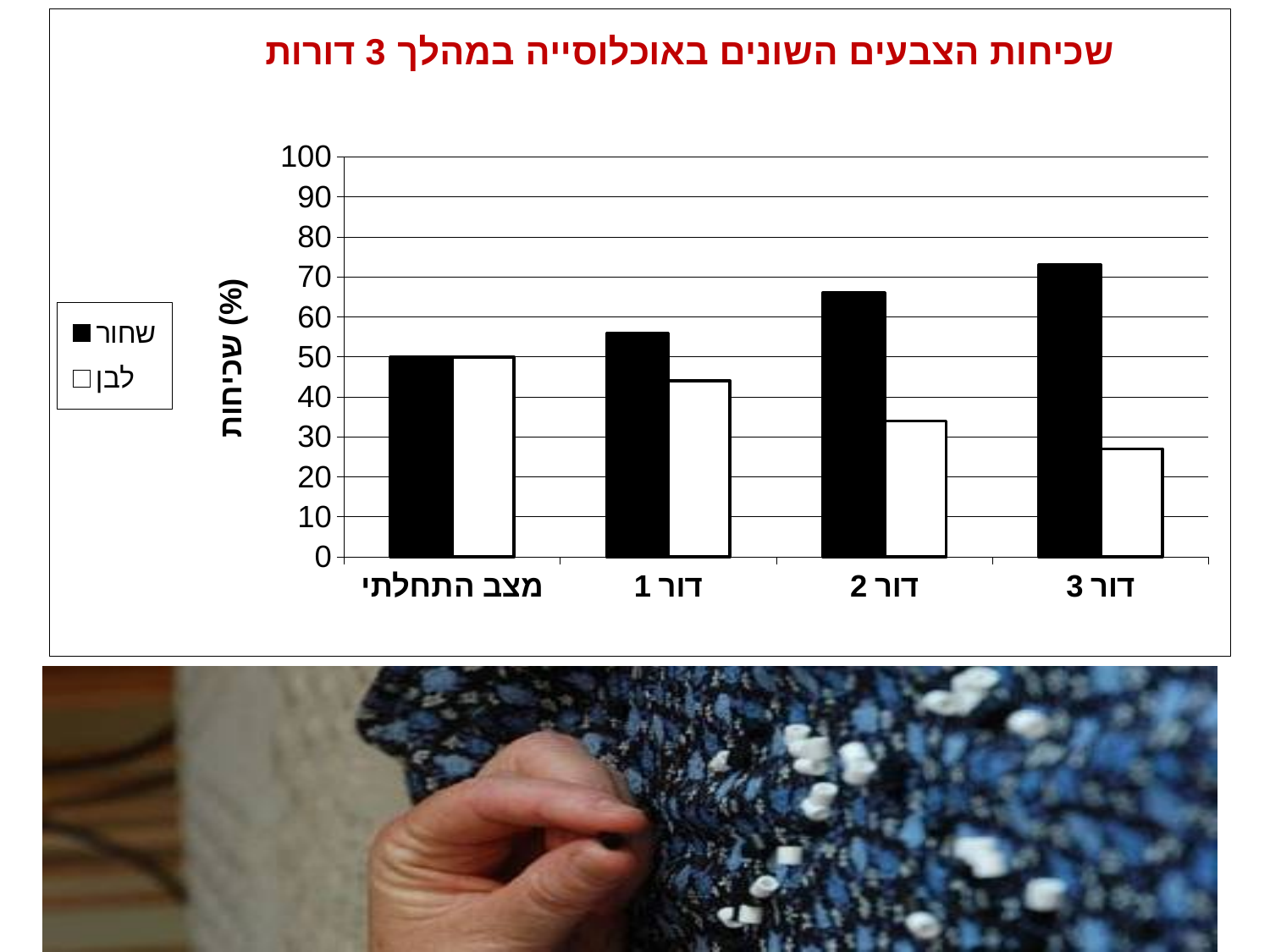
In which category is the value for שחור highest? דור 3 In which category is the value for לבן lowest? דור 3 Does the value for לבן rise or fall from מצב התחלתי to דור 3? fall Is the value for שחור in דור 1 greater or less than 50? greater What is the value for לבן in the מצב התחלתי category? 50 Is the value for שחור in דור 3 greater or less than 70? greater How many series does the legend list? 2 What is the value for שחור in the מצב התחלתי category? 50 How many categories are shown on the x axis? 4 What kind of chart is shown on the slide? bar chart Is the value for לבן in דור 2 greater or less than 40? less